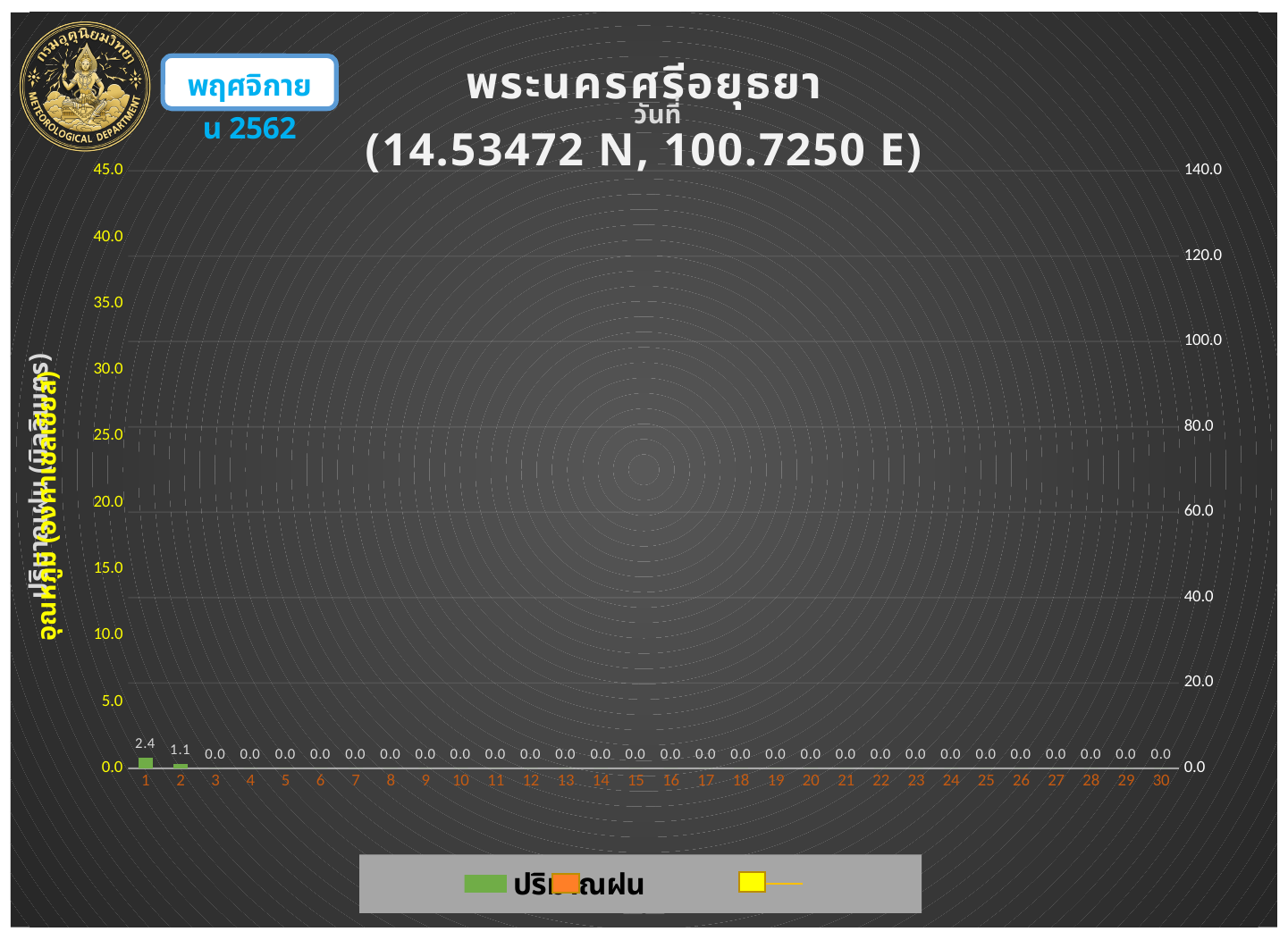
How many days are shown along the x axis? 30 What is the rainfall value shown for day 1? 2.4 What is the difference between the rainfall values for day 1 and day 2? 1.3 What is the rainfall value shown for day 2? 1.1 Which day has the highest rainfall value? 1 What kind of chart is used to show the rainfall values? bar chart Is the rainfall value for day 1 greater or less than 5.0? less Which is larger, the rainfall value for day 1 or for day 2? day 1 What is the rainfall value shown for day 15? 0.0 What is the highest tick value on the right-hand vertical axis? 140.0 What is the highest tick value on the left-hand vertical axis? 45.0 How many days have a rainfall value of 0.0? 28